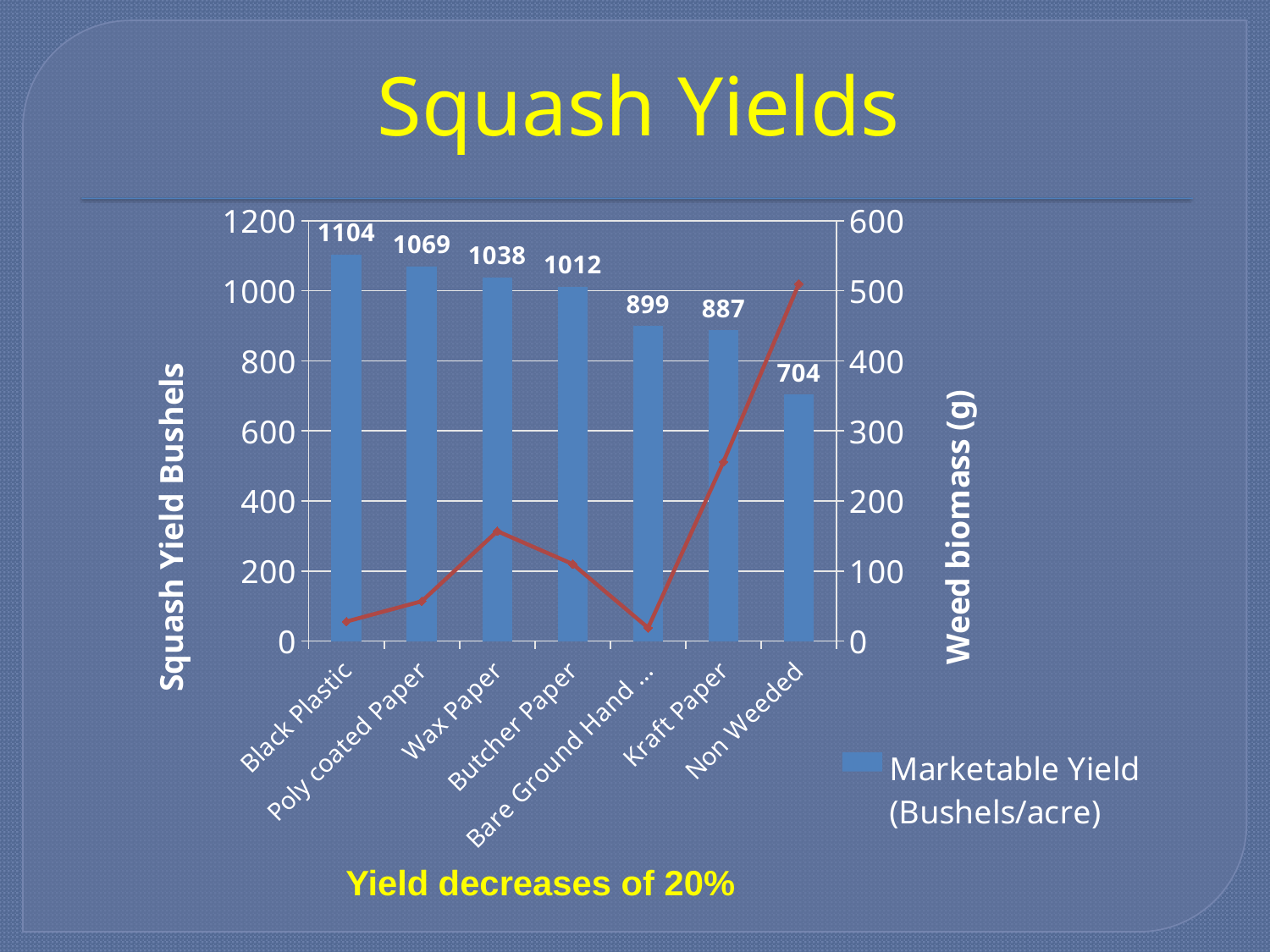
What is the difference in marketable yield between Black Plastic and Non Weeded? 400 Is the weed biomass value for Non Weeded greater or less than 400? greater What is the title of the left vertical axis? Squash Yield Bushels Which category has the lowest marketable yield? Non Weeded What kind of chart is shown on the slide? A bar chart combined with a line chart Do the marketable yield bars rise or fall from left to right along the x axis? fall Which has a higher marketable yield, Wax Paper or Butcher Paper? Wax Paper What is the marketable yield for Black Plastic? 1104 How many series does the legend list? 1 What is the marketable yield for Kraft Paper? 887 How many categories are shown on the x axis? 7 Which category has the highest marketable yield? Black Plastic